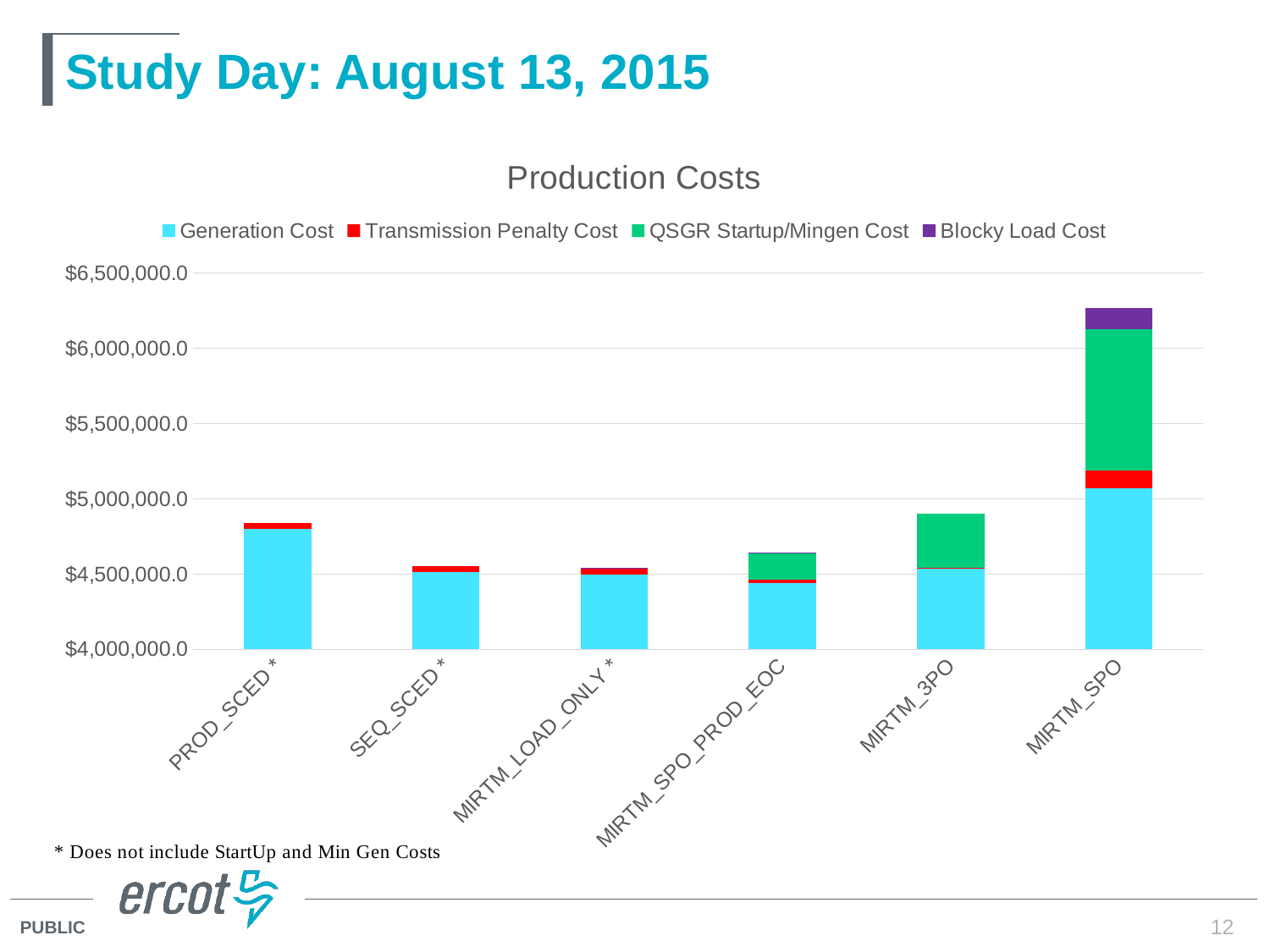
Which category is the only one showing a Blocky Load Cost segment? MIRTM_SPO Is the total value for MIRTM_SPO greater or less than $6,000,000.0? greater How many series does the legend list? 4 How many categories are shown on the x axis? 6 Which has the larger total production cost, PROD_SCED* or SEQ_SCED*? PROD_SCED* Is the total value for PROD_SCED* greater or less than $5,000,000.0? less Which has the larger total production cost, MIRTM_3PO or MIRTM_SPO_PROD_EOC? MIRTM_3PO Is the total value for MIRTM_3PO greater or less than $5,000,000.0? less What is the title of the chart? Production Costs What kind of chart is shown on the slide? Stacked bar chart Which category has the highest total production cost? MIRTM_SPO